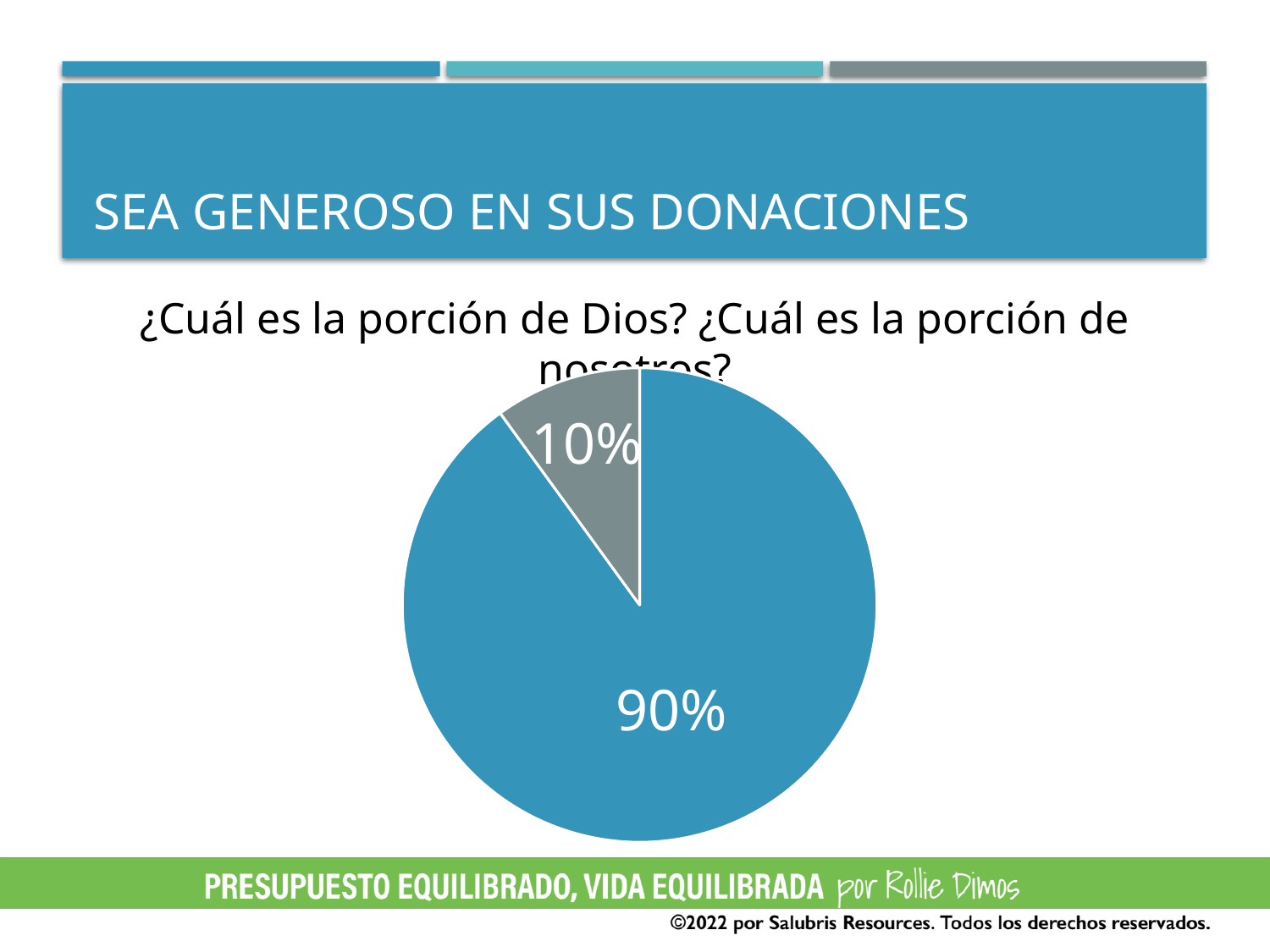
Which slice is larger, the blue slice or the gray slice? the blue slice What kind of chart is shown on the slide? pie chart What is the value of the largest slice of the pie chart? 90% What share of the pie does the blue slice represent? 90% What colour is the 10% slice of the pie chart? gray What is the difference between the two slices of the pie chart? 80% What colour is the 90% slice of the pie chart? blue Is the value of the gray slice greater or less than 50%? less How many slices does the pie chart have? 2 What is the value of the smallest slice of the pie chart? 10% What do the two slices of the pie chart add up to? 100%